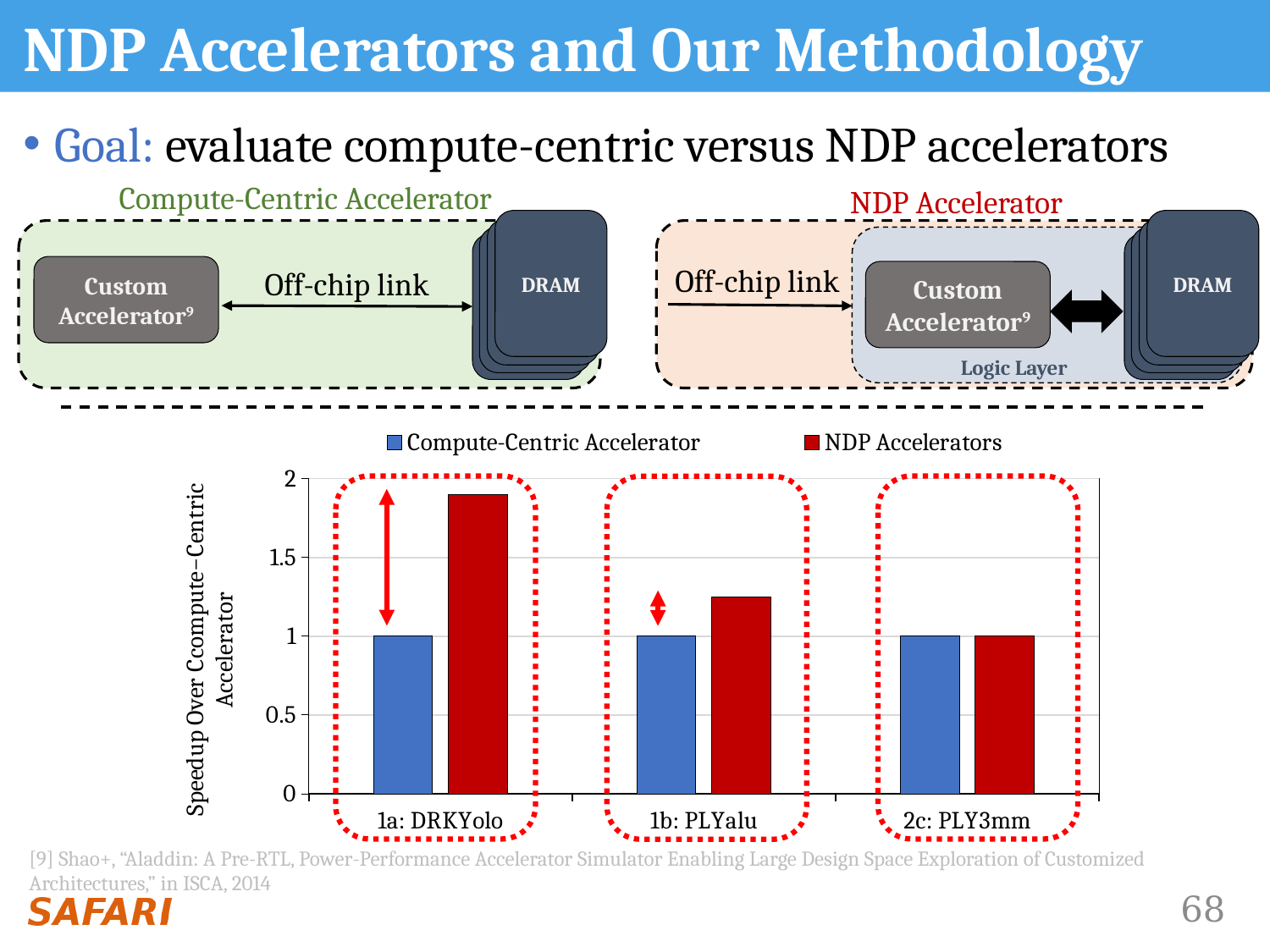
What kind of chart is shown on the slide? bar chart What is the label of the chart's y axis? Speedup Over Ccompute-Centric Accelerator How many categories are shown on the x axis of the chart? 3 How many series does the chart's legend list? 2 What is the speedup value of the Compute-Centric Accelerator for 1a: DRKYolo? 1 Which category has the highest NDP Accelerators speedup? 1a: DRKYolo Which category has the lowest NDP Accelerators speedup? 2c: PLY3mm Which series is shown in red in the chart's legend? NDP Accelerators Is the NDP Accelerators value for 1b: PLYalu greater or less than 1.5? less Is the NDP Accelerators value for 1a: DRKYolo greater or less than 1.5? greater For 1a: DRKYolo, which series has the larger value, Compute-Centric Accelerator or NDP Accelerators? NDP Accelerators What is the speedup value of the NDP Accelerators for 2c: PLY3mm? 1